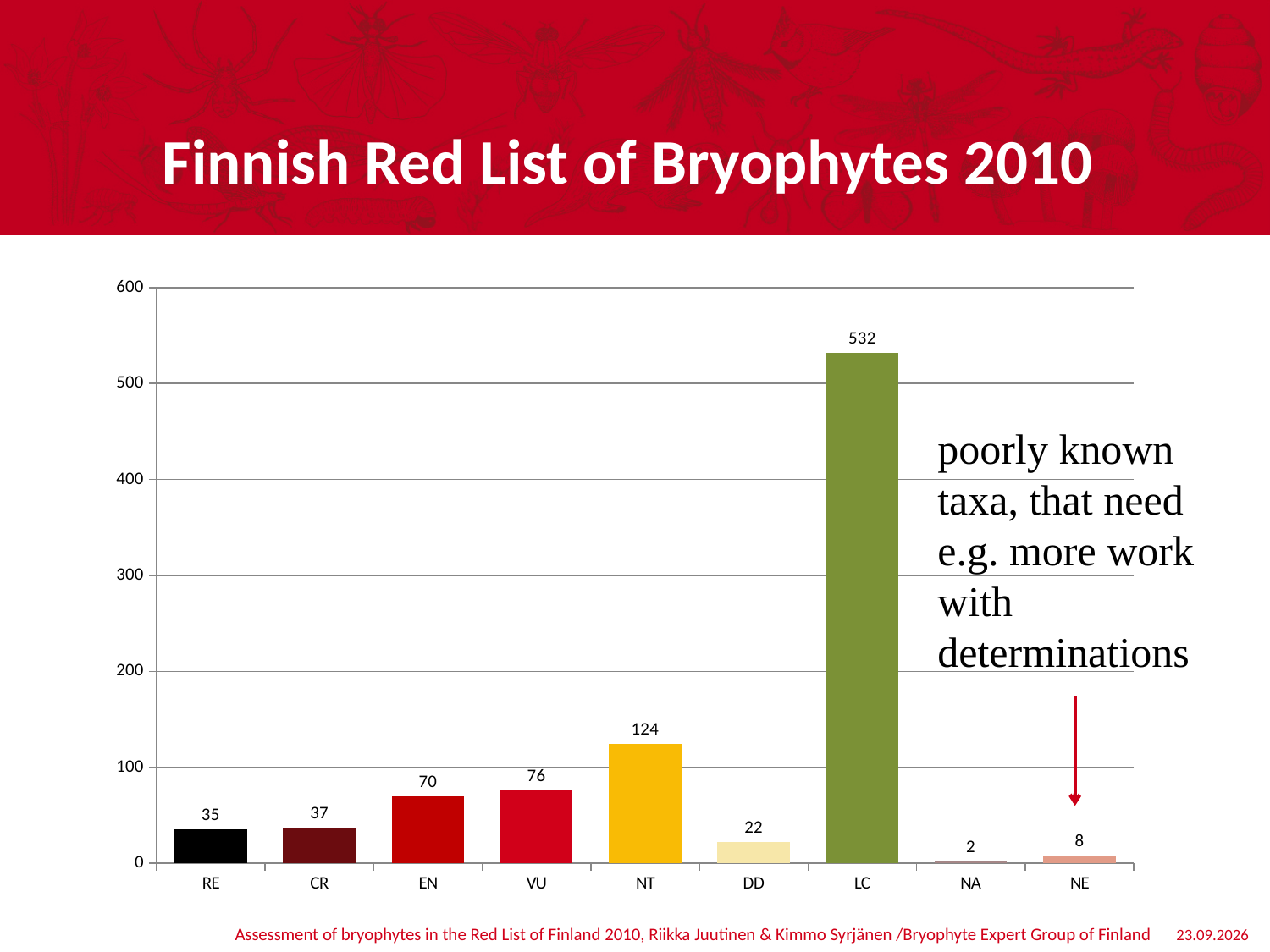
Which category has the highest value? LC What is the difference between the values for VU and EN? 6 What is the value for NT? 124 What is the difference between the values for NT and DD? 102 What is the title of the slide? Finnish Red List of Bryophytes 2010 What is the value for NA? 2 What kind of chart is shown on the slide? bar chart Which category has the lowest value? NA What is the value for LC? 532 Which is larger, the value for RE or the value for CR? CR Is the value for LC greater or less than 500? greater How many categories are shown on the x axis? 9